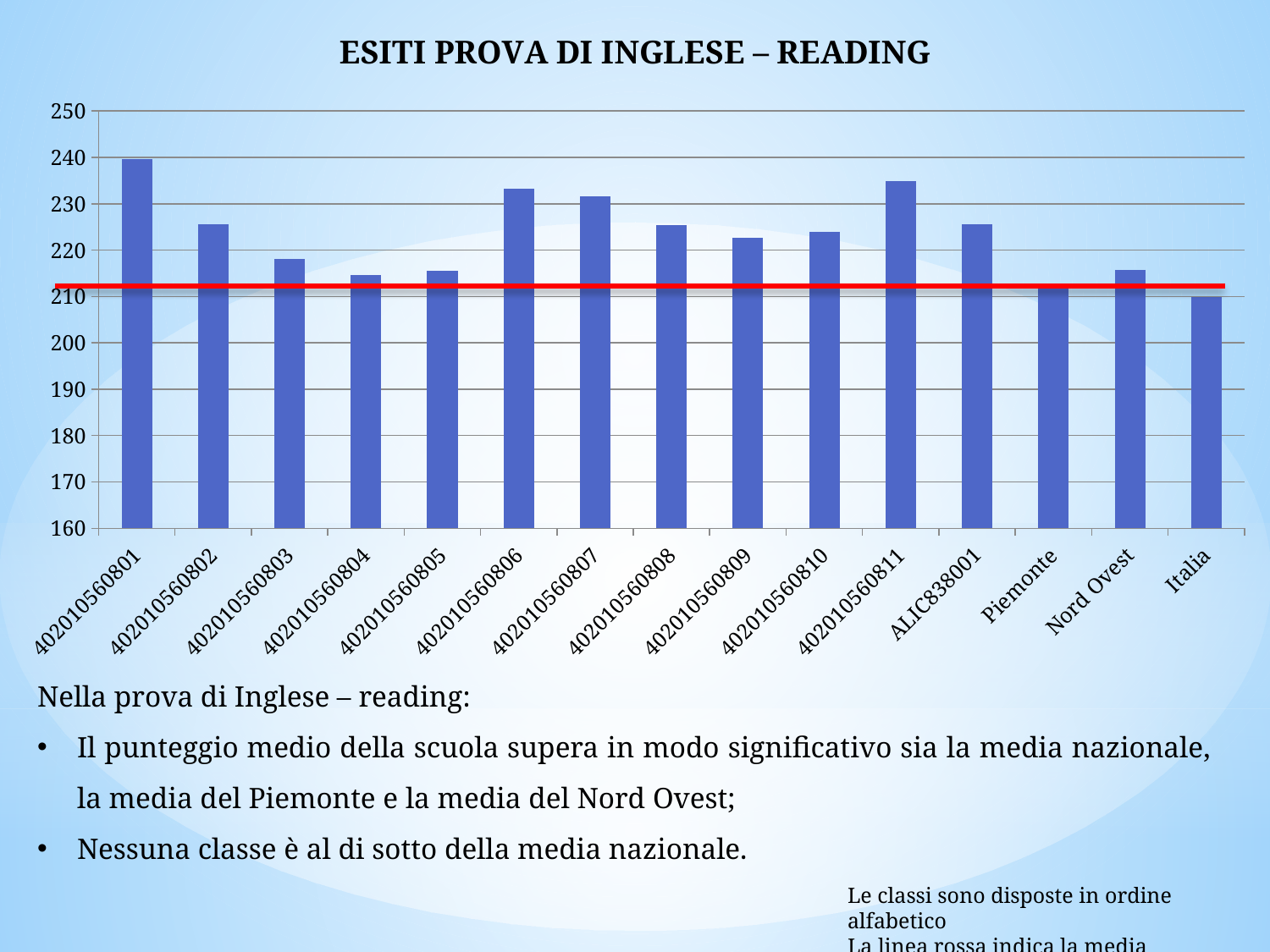
Is the value for 402010560803 greater or less than 220? less Which category has the lowest bar in the chart? Italia Is the value for 402010560801 greater or less than 230? greater How many categories are shown on the x axis of the chart? 15 Which category has the highest bar in the chart? 402010560801 Is the value for 402010560808 greater or less than 220? greater Which is larger, the value for 402010560802 or the value for 402010560803? 402010560802 Which is larger, the value for 402010560811 or the value for ALIC838001? 402010560811 What is the title of the chart? ESITI PROVA DI INGLESE – READING What kind of chart is shown on the slide? bar chart